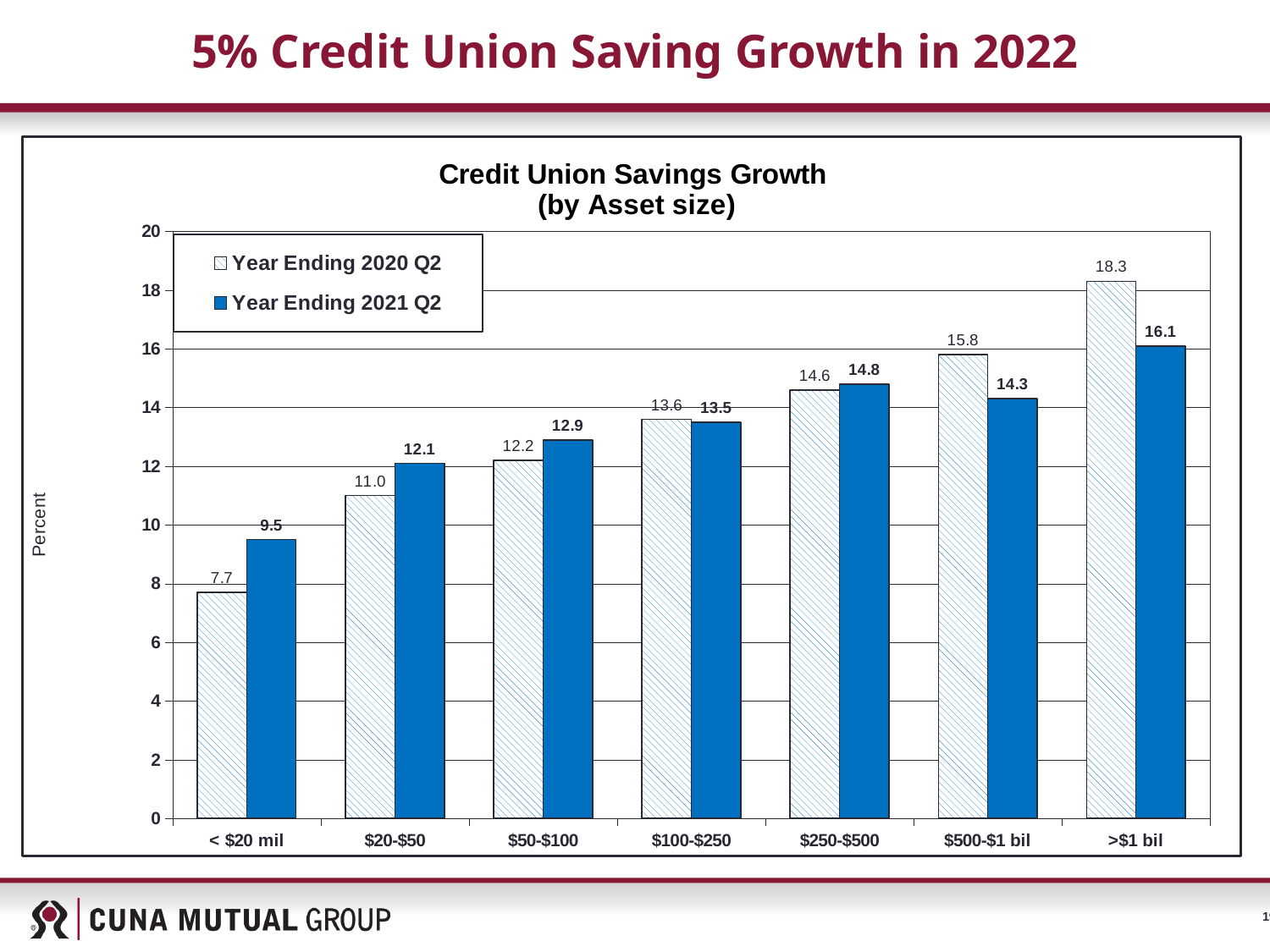
Which asset size category has the highest Year Ending 2021 Q2 value? >$1 bil How many series does the legend list? 2 Which asset size category has the lowest Year Ending 2020 Q2 value? < $20 mil How many asset size categories are shown on the x axis? 7 What is the Year Ending 2021 Q2 value for the $250-$500 category? 14.8 What kind of chart is shown on the slide? Bar chart What is the difference between the Year Ending 2021 Q2 and Year Ending 2020 Q2 values for the < $20 mil category? 1.8 Do the Year Ending 2020 Q2 values rise or fall as asset size increases along the x axis? Rise What is the Year Ending 2021 Q2 value for the $20-$50 asset size category? 12.1 For the $500-$1 bil category, which series has the larger value: Year Ending 2020 Q2 or Year Ending 2021 Q2? Year Ending 2020 Q2 What is the title of the chart? Credit Union Savings Growth (by Asset size) What is the Year Ending 2020 Q2 value for the >$1 bil asset size category? 18.3